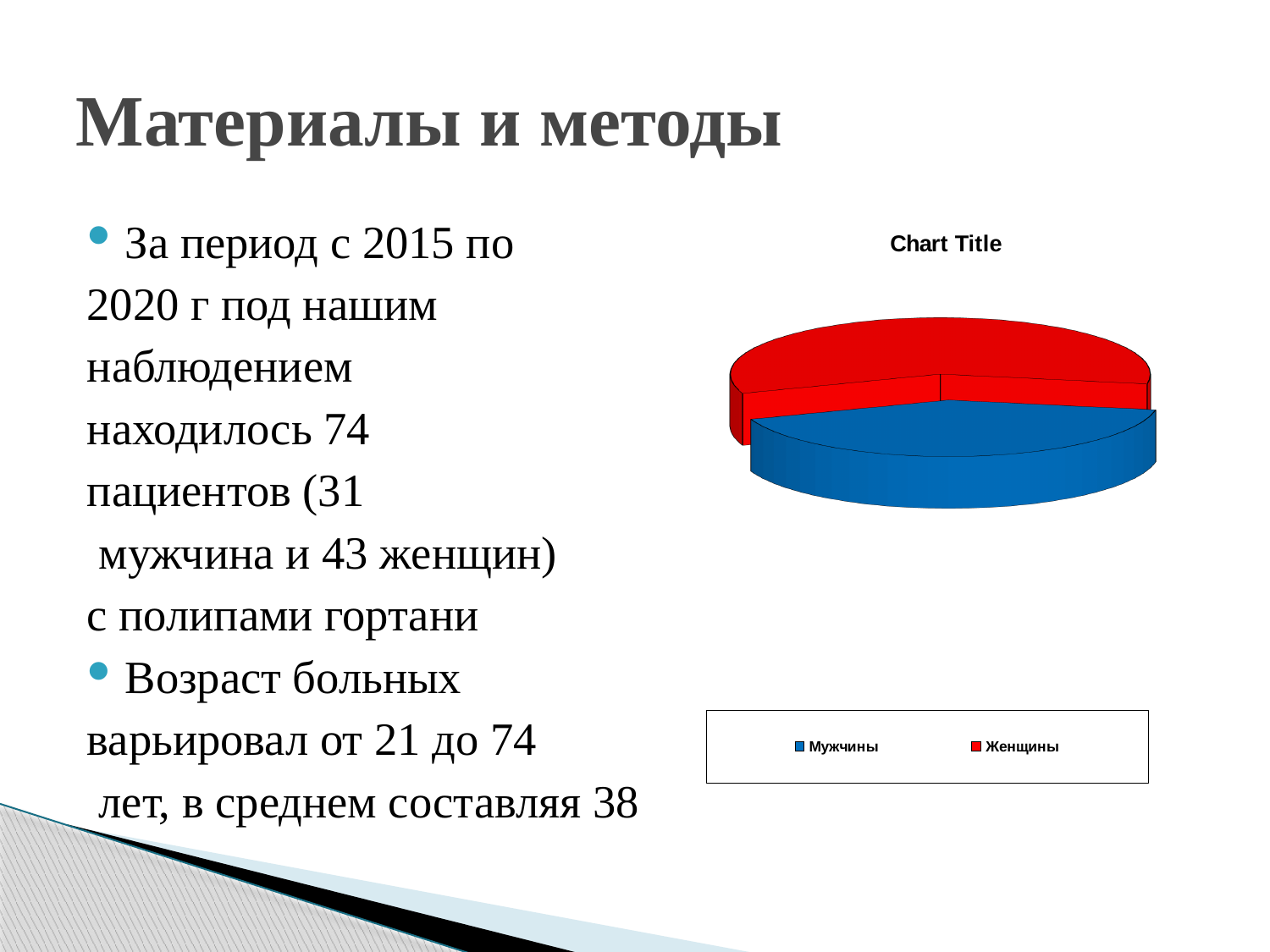
Which legend entry is shown in blue on the pie chart? Мужчины What kind of chart is shown on the slide? pie chart What is the title shown above the pie chart? Chart Title Which category has the smallest slice in the pie chart? Мужчины How many slices does the pie chart have? 2 How many entries does the legend of the pie chart list? 2 Which category has the larger slice in the pie chart, Мужчины or Женщины? Женщины